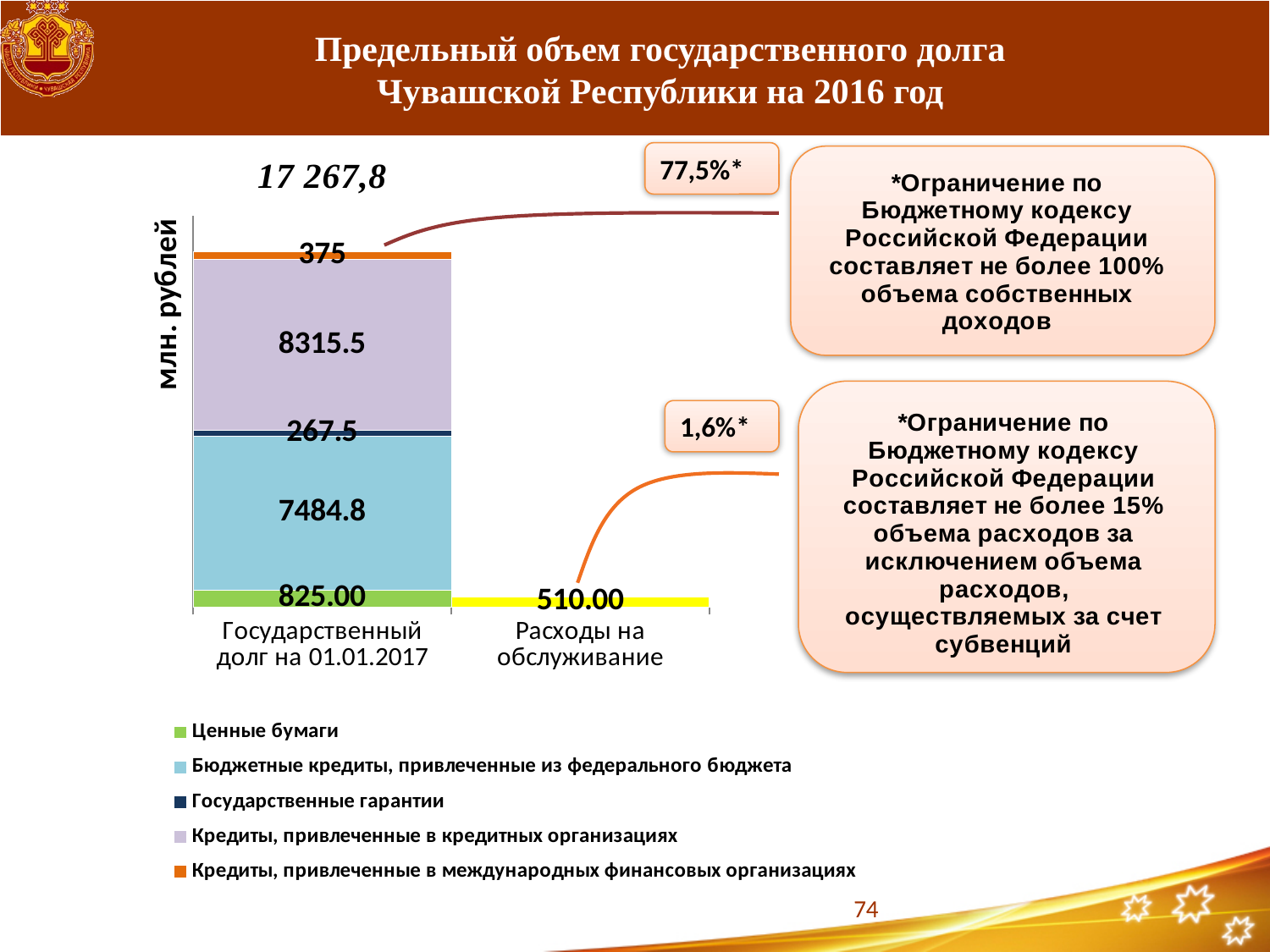
What is the difference between the Кредиты, привлеченные в кредитных организациях segment and the Бюджетные кредиты, привлеченные из федерального бюджета segment? 830.7 What kind of chart is shown on the slide? Stacked bar chart What is the value of the Ценные бумаги segment in the Государственный долг на 01.01.2017 bar? 825.00 What is the value shown for Расходы на обслуживание? 510.00 Which segment of the Государственный долг на 01.01.2017 bar has the largest value? Кредиты, привлеченные в кредитных организациях How many categories are shown on the x axis? 2 What is the total of the Государственный долг на 01.01.2017 stacked bar? 17 267,8 How many series does the legend list? 5 What is the value of the Государственные гарантии segment? 267.5 What is the value of the Бюджетные кредиты, привлеченные из федерального бюджета segment? 7484.8 What is the label on the vertical axis? млн. рублей What is the value of the Кредиты, привлеченные в кредитных организациях segment? 8315.5